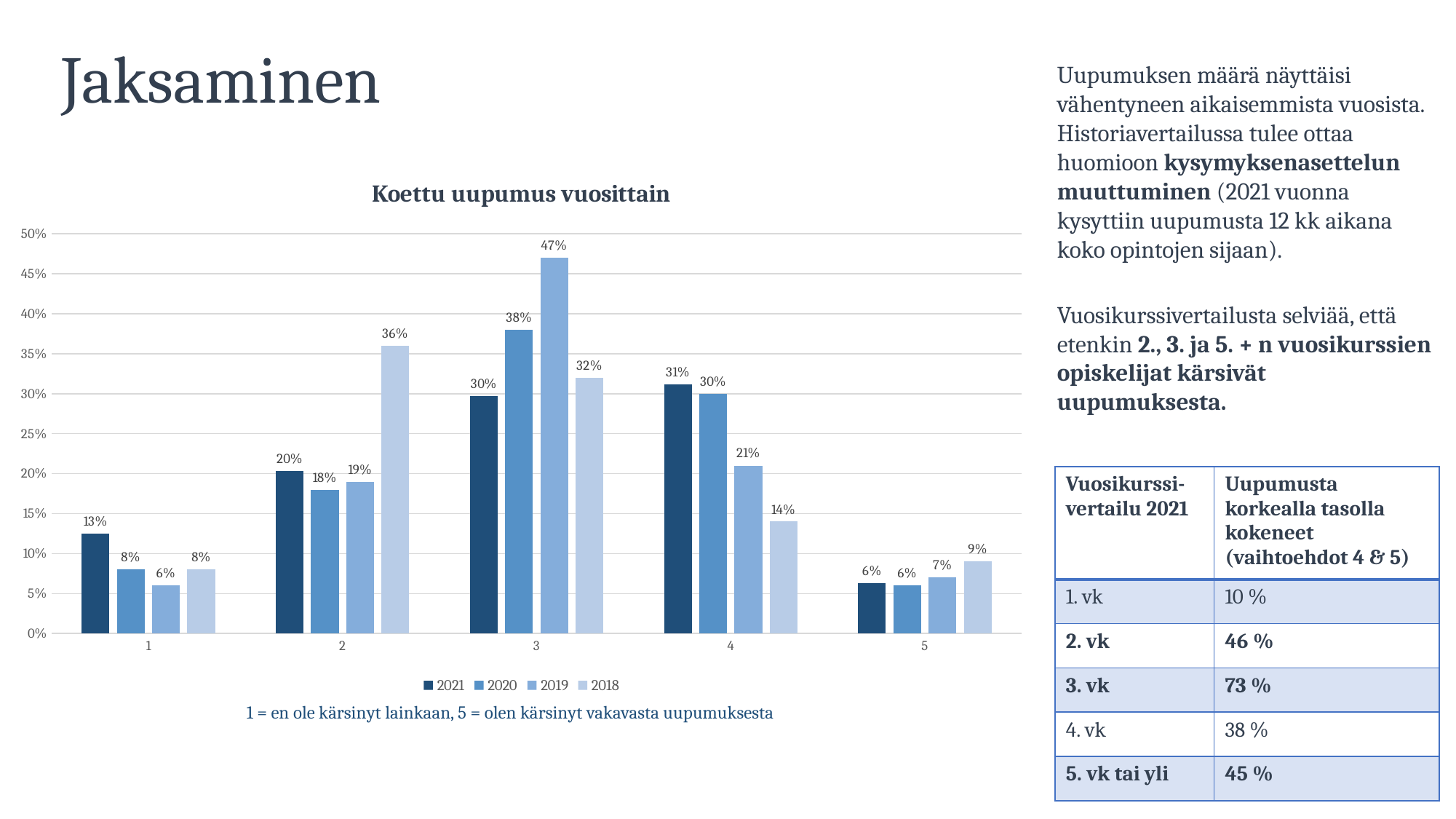
How many series does the chart legend list? 4 What is the value for category 2 in the 2018 series? 36% What is the value for category 4 in the 2019 series? 21% For category 2, which is larger: the 2018 value or the 2021 value? 2018 Which category has the lowest value in the 2018 series? 1 Which category has the highest value in the 2021 series? 4 What is the difference between the 2019 and 2021 values for category 3? 17% How many categories are shown on the x axis of the chart? 5 What is the title of the chart? Koettu uupumus vuosittain What kind of chart is shown on the slide? Bar chart What is the value for category 1 in the 2021 series? 13% What is the value for category 3 in the 2019 series in the chart 'Koettu uupumus vuosittain'? 47%